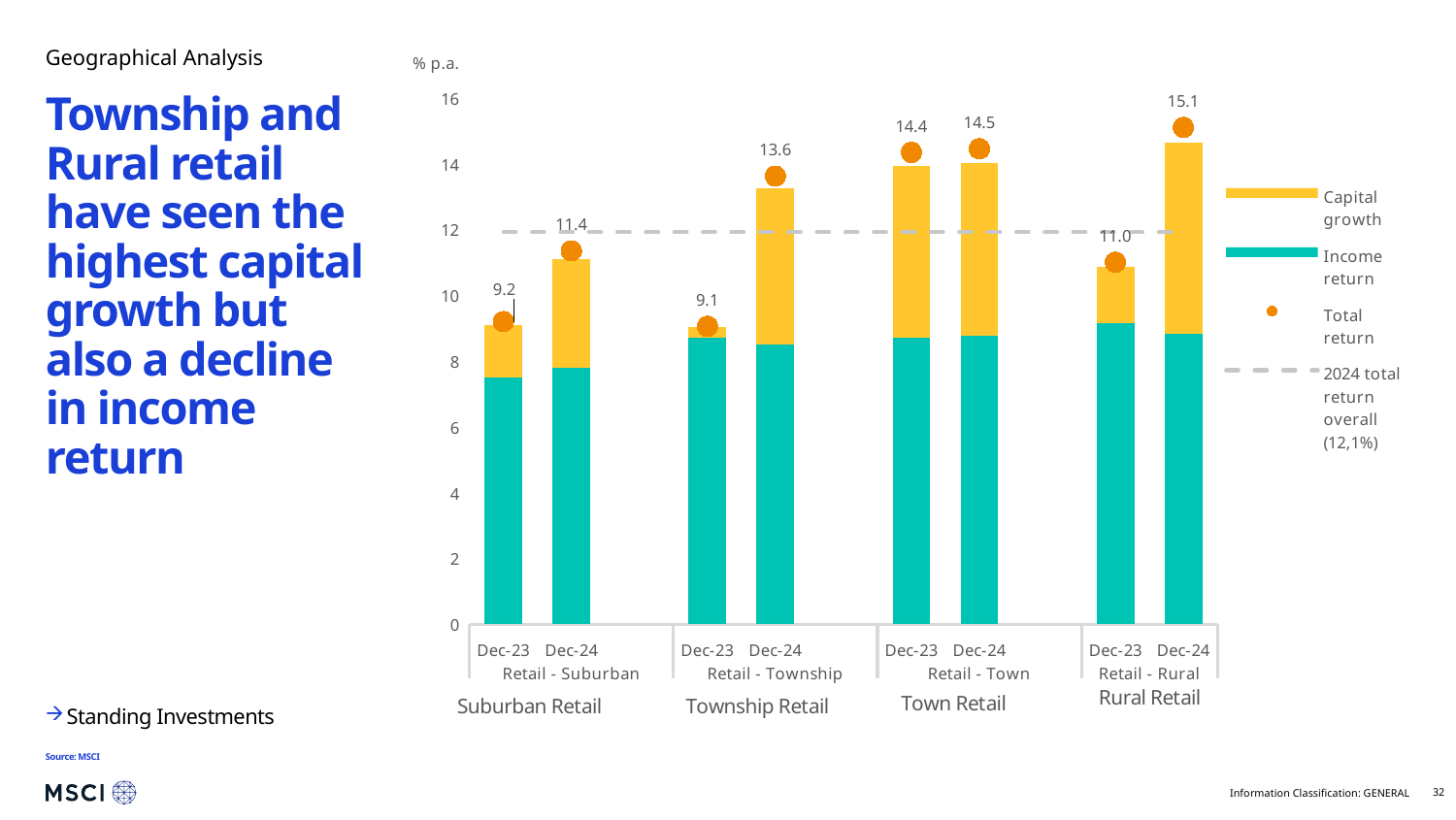
How many entries does the legend list? 4 What is the difference between the Dec-24 and Dec-23 total return for Retail - Rural? 4.1 What is the total return for Retail - Township in Dec-23? 9.1 What is the 2024 total return overall shown by the dashed line? 12,1% Which bar has the lowest total return? Retail - Township, Dec-23 By how much did the total return for Retail - Township increase from Dec-23 to Dec-24? 4.5 Which bar has the highest total return? Retail - Rural, Dec-24 How many bars are plotted in the chart? 8 Is the income return for Retail - Suburban in Dec-23 greater or less than 8? less What is the total return for Retail - Suburban in Dec-24? 11.4 What is the total return for Retail - Rural in Dec-24? 15.1 Which has the larger total return in Dec-23: Retail - Town or Retail - Rural? Retail - Town